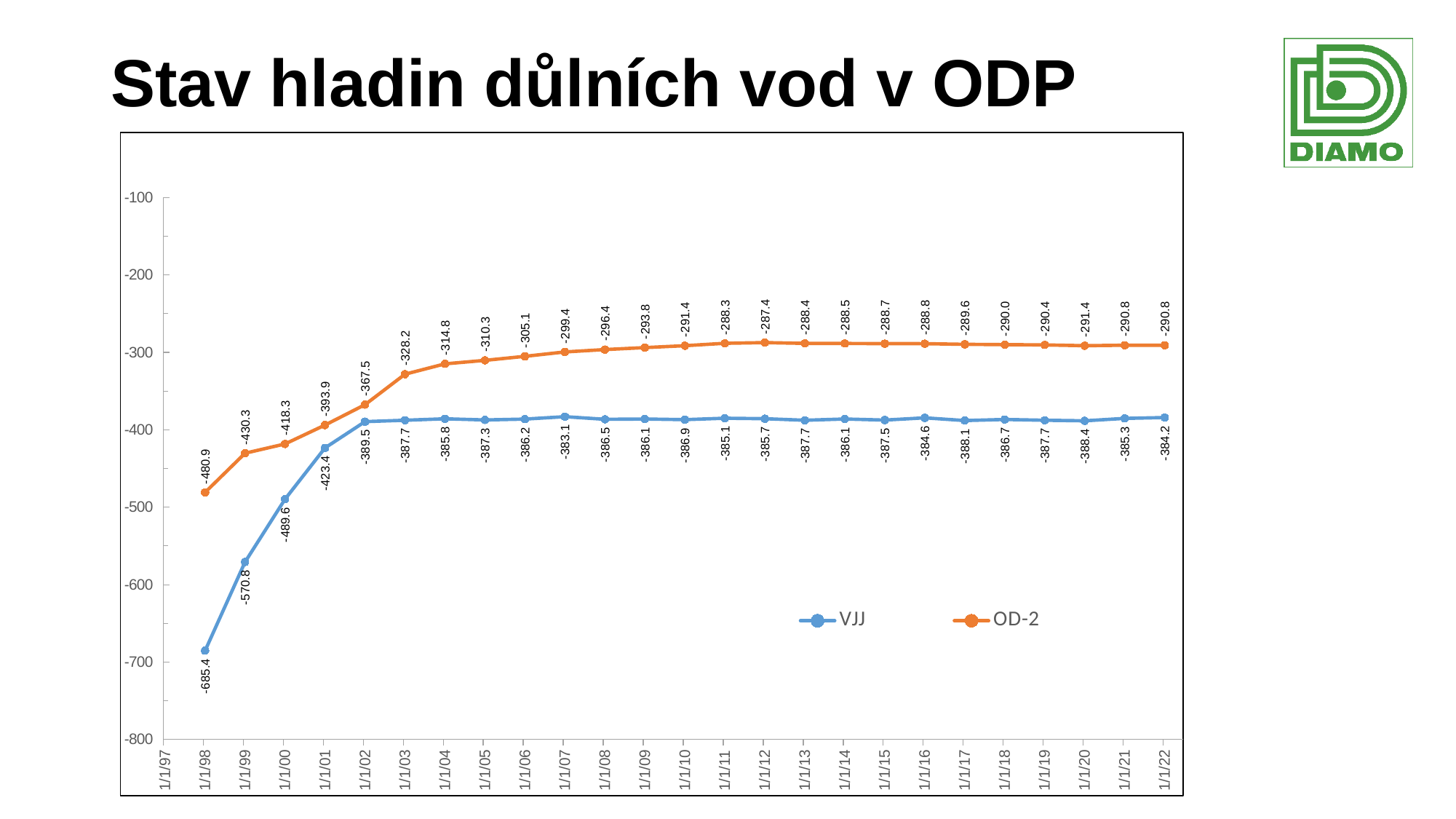
What type of chart is shown on the slide? line chart What is the value of VJJ at 1/1/07? -383.1 What is the value of VJJ at 1/1/98? -685.4 What is the title of the slide? Stav hladin důlních vod v ODP What is the value of OD-2 at 1/1/22? -290.8 Does the VJJ series rise or fall between 1/1/98 and 1/1/02? rise What is the difference between the OD-2 and VJJ values at 1/1/22? 93.4 Which series has the higher value at 1/1/01, VJJ or OD-2? OD-2 At which date does the VJJ series have its lowest value? 1/1/98 What is the value of OD-2 at 1/1/03? -328.2 How many series does the legend list? 2 At which date does the OD-2 series reach its highest value? 1/1/12